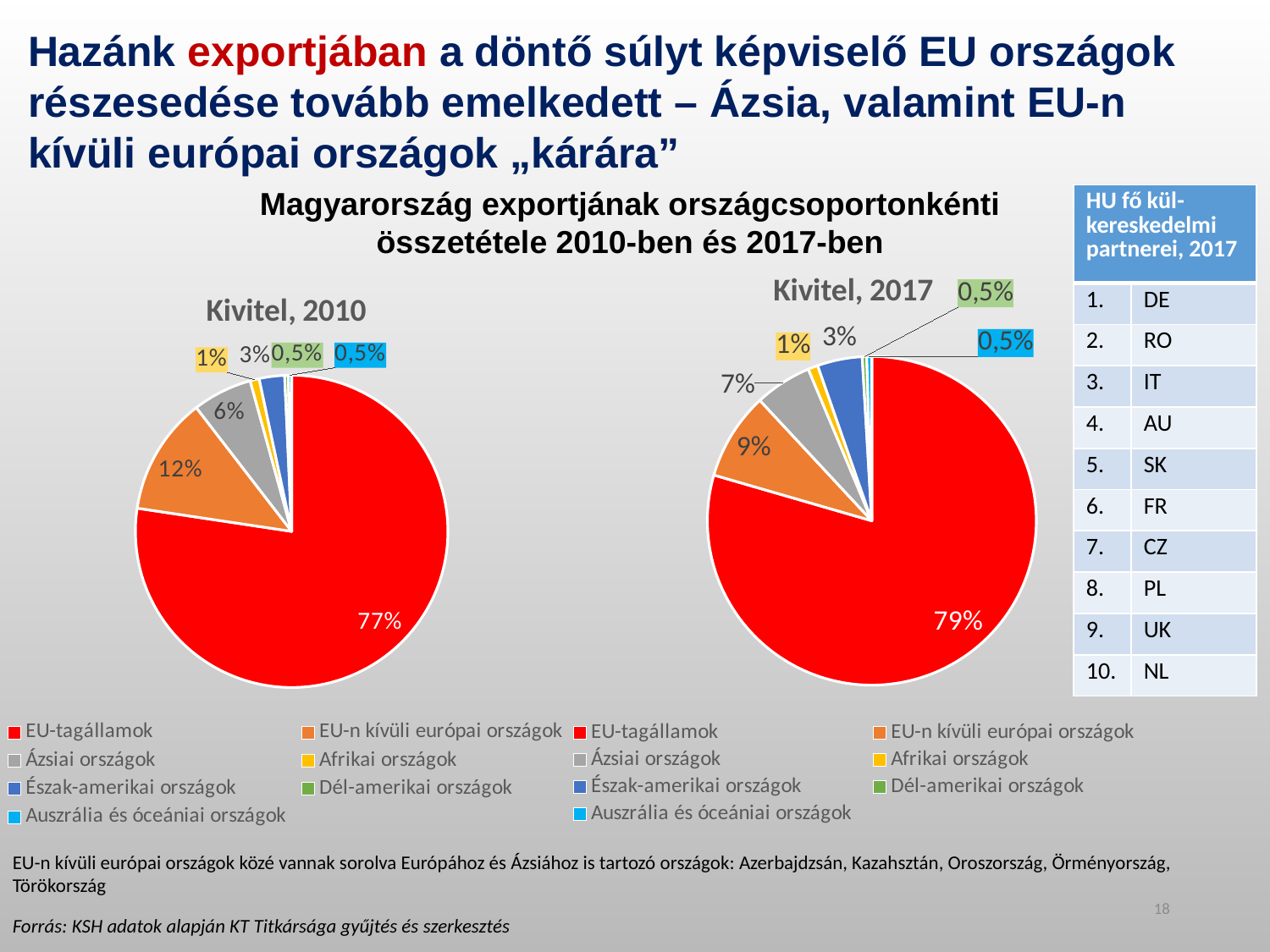
In the 'Kivitel, 2017' pie chart, which category has the largest share? EU-tagállamok In the 'Kivitel, 2010' pie chart, what share do Ázsiai országok have? 6% In the 'Kivitel, 2010' pie chart, what colour represents EU-tagállamok? Red By how many percentage points did the share of EU-tagállamok change between the 'Kivitel, 2010' and 'Kivitel, 2017' pie charts? 2 percentage points In the 'Kivitel, 2017' pie chart, what share do Ázsiai országok have? 7% What type of chart is 'Kivitel, 2010'? Pie chart Is the share of EU-n kívüli európai országok larger in the 'Kivitel, 2010' chart or the 'Kivitel, 2017' chart? Kivitel, 2010 In the 'Kivitel, 2017' pie chart, what share do EU-tagállamok have? 79% In the 'Kivitel, 2010' pie chart, what share do EU-tagállamok have? 77% In the 'Kivitel, 2017' pie chart, what share do EU-n kívüli európai országok have? 9% How many categories does the legend of the 'Kivitel, 2017' pie chart list? 7 In the 'Kivitel, 2010' pie chart, what share do EU-n kívüli európai országok have? 12%